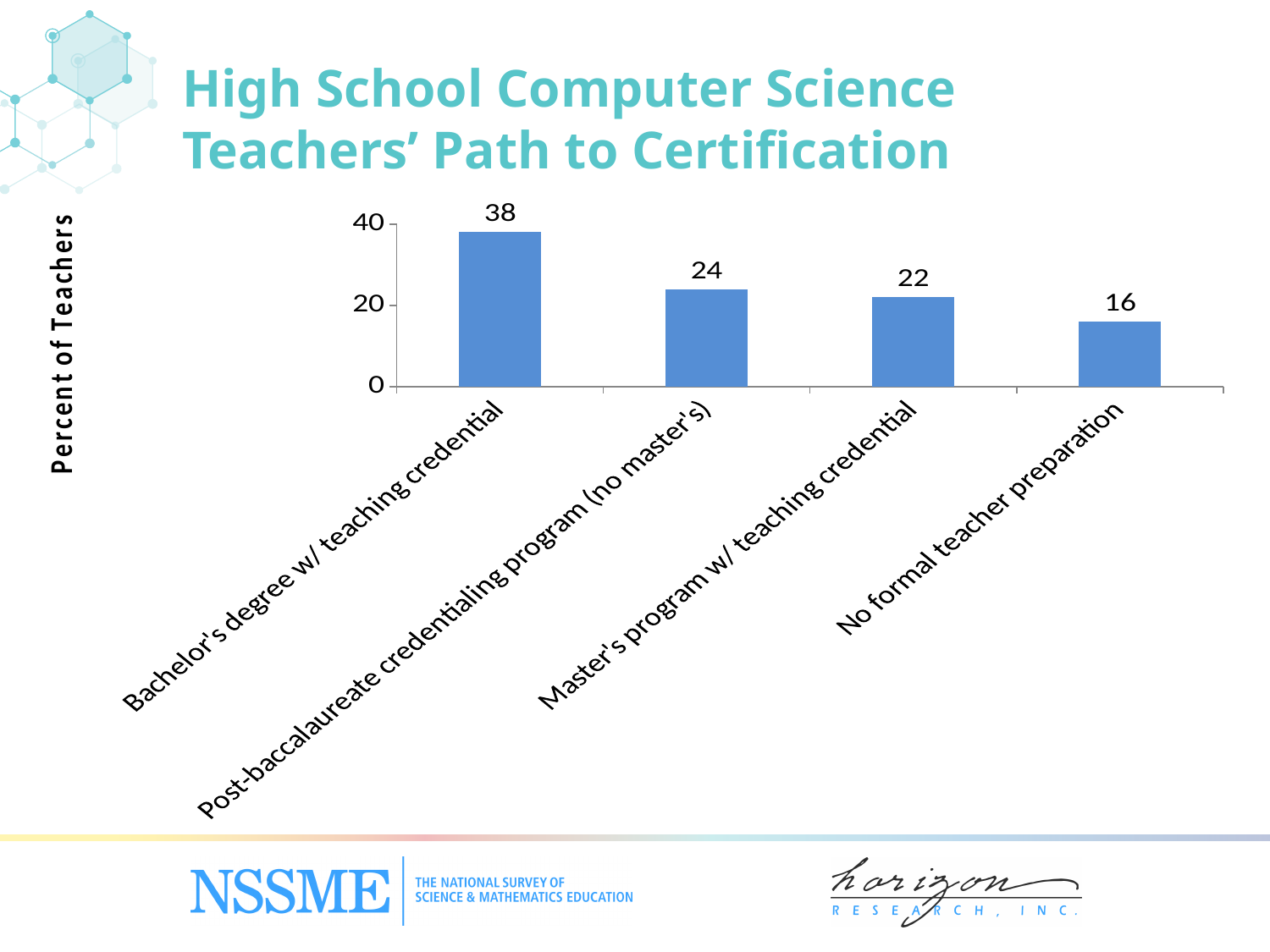
Is the value for 'Bachelor's degree w/ teaching credential' greater or less than 20? greater What percent of teachers have a bachelor's degree with teaching credential? 38 Which path to certification has the highest percent of teachers? Bachelor's degree w/ teaching credential What is the value for 'Post-baccalaureate credentialing program (no master's)'? 24 What kind of chart is shown on the slide? Bar chart What is the difference between the values for 'Bachelor's degree w/ teaching credential' and 'No formal teacher preparation'? 22 How many categories are shown on the chart? 4 Which category has the lowest percent of teachers? No formal teacher preparation Which is larger: the value for 'Post-baccalaureate credentialing program (no master's)' or 'Master's program w/ teaching credential'? Post-baccalaureate credentialing program (no master's) What percent of teachers had no formal teacher preparation? 16 What is the label of the vertical axis? Percent of Teachers What is the value for 'Master's program w/ teaching credential'? 22